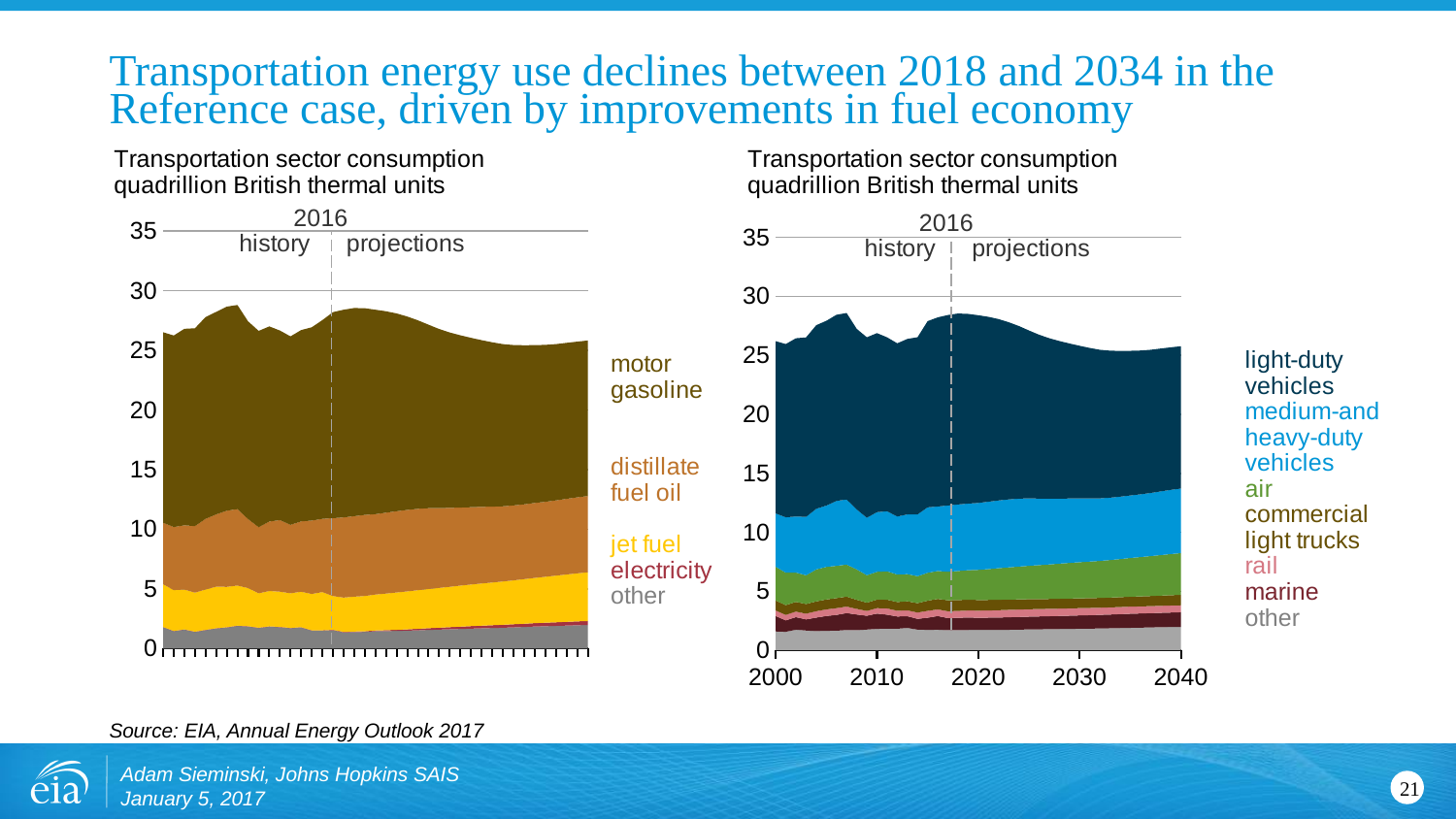
In the right chart, is the total transportation sector consumption in 2040 greater or less than 30? less In the right chart, which series accounts for the largest share of transportation sector consumption? light-duty vehicles How many series does the legend of the right chart list? 7 What unit of measurement is used on the y axis of both charts? quadrillion British thermal units How many series does the legend of the left chart list? 5 In the left chart, which series accounts for the largest share of transportation sector consumption? motor gasoline What kind of chart is the left chart on the slide? stacked area chart In the right chart, is the total transportation sector consumption in 2016 greater or less than 25? greater Which year does the dashed vertical line separating history from projections mark in both charts? 2016 In the left chart, which series accounts for the smallest share of transportation sector consumption? electricity In the right chart, does total transportation sector consumption rise or fall between 2018 and 2034? fall